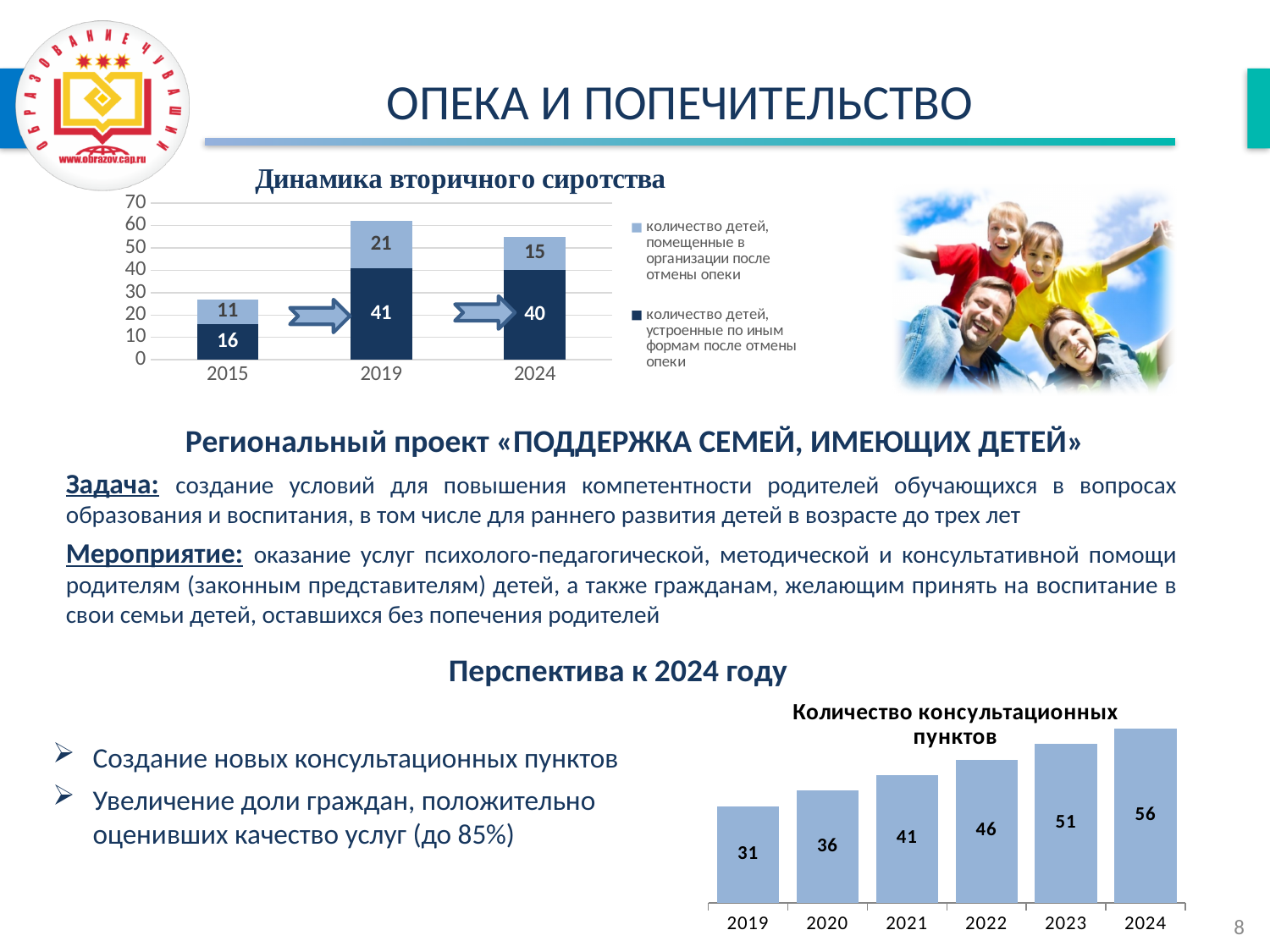
In the chart 'Динамика вторичного сиротства', what is the difference between the 'помещенные в организации' values for 2019 and 2024? 6 In the chart 'Количество консультационных пунктов', do the values rise or fall from 2019 to 2024? rise In the chart 'Динамика вторичного сиротства', what is the value for 'количество детей, устроенные по иным формам после отмены опеки' in 2019? 41 In the chart 'Количество консультационных пунктов', what is the value for 2022? 46 In the chart 'Динамика вторичного сиротства', how many series does the legend list? 2 In the chart 'Динамика вторичного сиротства', what is the value for 'количество детей, помещенные в организации после отмены опеки' in 2024? 15 In the chart 'Количество консультационных пунктов', which year has the lowest value? 2019 In the chart 'Динамика вторичного сиротства', what is the total of the stacked bar for 2019? 62 In the chart 'Количество консультационных пунктов', how many years are shown on the x axis? 6 In the chart 'Динамика вторичного сиротства', what is the total of the stacked bar for 2015? 27 In the chart 'Количество консультационных пунктов', what is the difference between the values for 2024 and 2019? 25 In the chart 'Динамика вторичного сиротства', which year has the highest value for 'количество детей, устроенные по иным формам после отмены опеки'? 2019